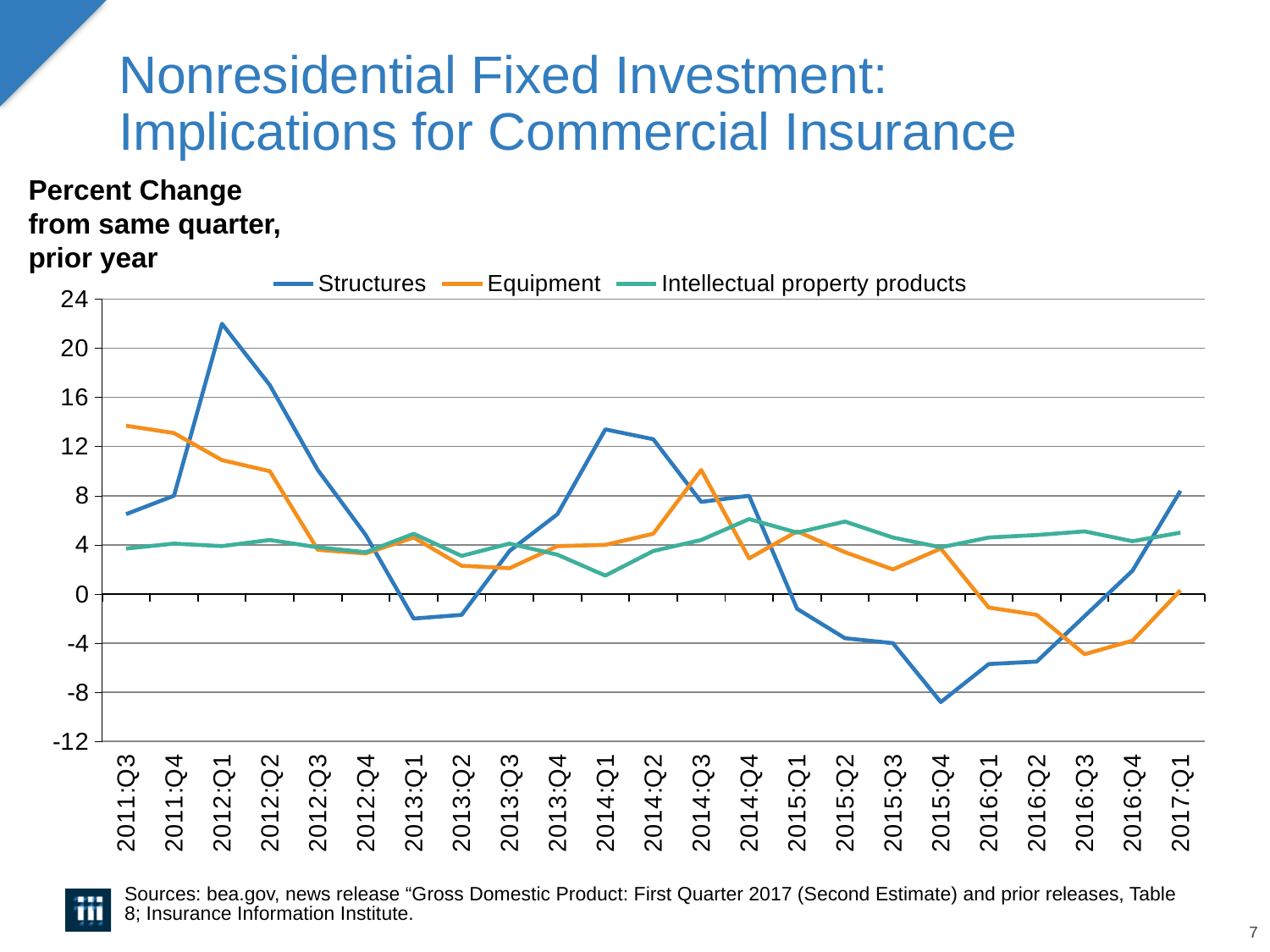
Does the Structures series rise or fall from 2015:Q4 to 2017:Q1? Rise Is the value for Structures in 2015:Q4 greater or less than -8? less Which series reaches the highest value anywhere on the chart? Structures What kind of chart is shown on the slide? Line chart How many quarters are plotted along the x axis? 23 Is the value for Equipment in 2011:Q3 greater or less than 12? greater In which quarter does the Structures series reach its highest value? 2012:Q1 In 2015:Q4, which series has the larger value, Structures or Intellectual property products? Intellectual property products How many series does the legend list? 3 Is the value for Structures in 2012:Q1 greater or less than 20? greater In which quarter does the Equipment series reach its lowest value? 2016:Q3 In which quarter does the Structures series reach its lowest value? 2015:Q4